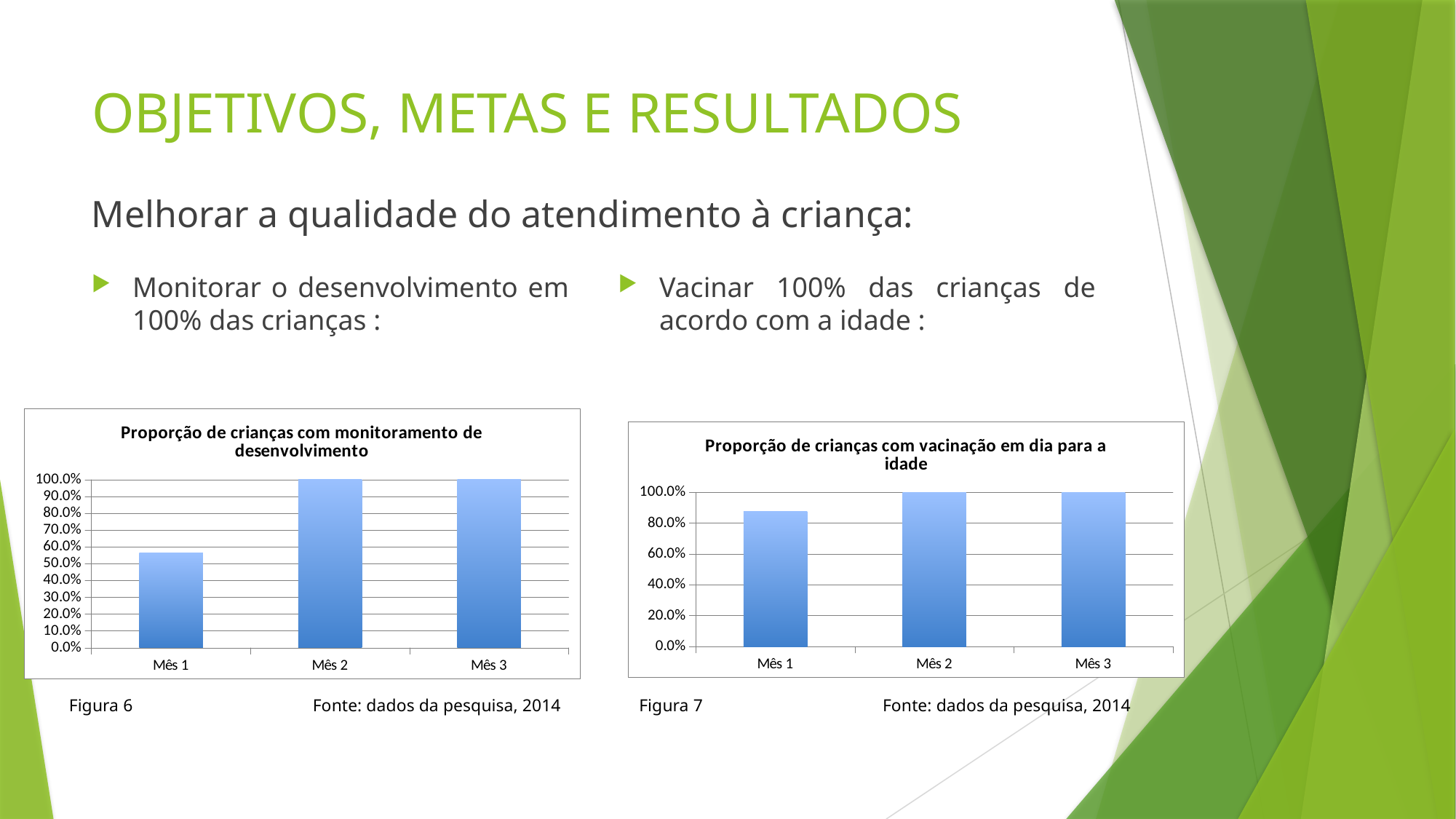
In the chart titled 'Proporção de crianças com vacinação em dia para a idade', is the value for Mês 1 greater or less than 80.0%? greater What kind of chart is the chart titled 'Proporção de crianças com monitoramento de desenvolvimento'? Bar chart What is the figure number given below the left chart? Figura 6 In the chart titled 'Proporção de crianças com monitoramento de desenvolvimento', what is the value for Mês 2? 100.0% In the chart titled 'Proporção de crianças com vacinação em dia para a idade', do the values rise or fall from Mês 1 to Mês 2? Rise In the chart titled 'Proporção de crianças com vacinação em dia para a idade', which month has the lowest value? Mês 1 In the chart titled 'Proporção de crianças com vacinação em dia para a idade', what is the value for Mês 3? 100.0% How many categories are shown on the x axis of the chart titled 'Proporção de crianças com vacinação em dia para a idade'? 3 What is the source cited below the right chart? Fonte: dados da pesquisa, 2014 In the chart titled 'Proporção de crianças com monitoramento de desenvolvimento', which month has the lowest value? Mês 1 In the chart titled 'Proporção de crianças com monitoramento de desenvolvimento', which is larger, the value for Mês 1 or Mês 2? Mês 2 In the chart titled 'Proporção de crianças com monitoramento de desenvolvimento', is the value for Mês 1 greater or less than 70.0%? less